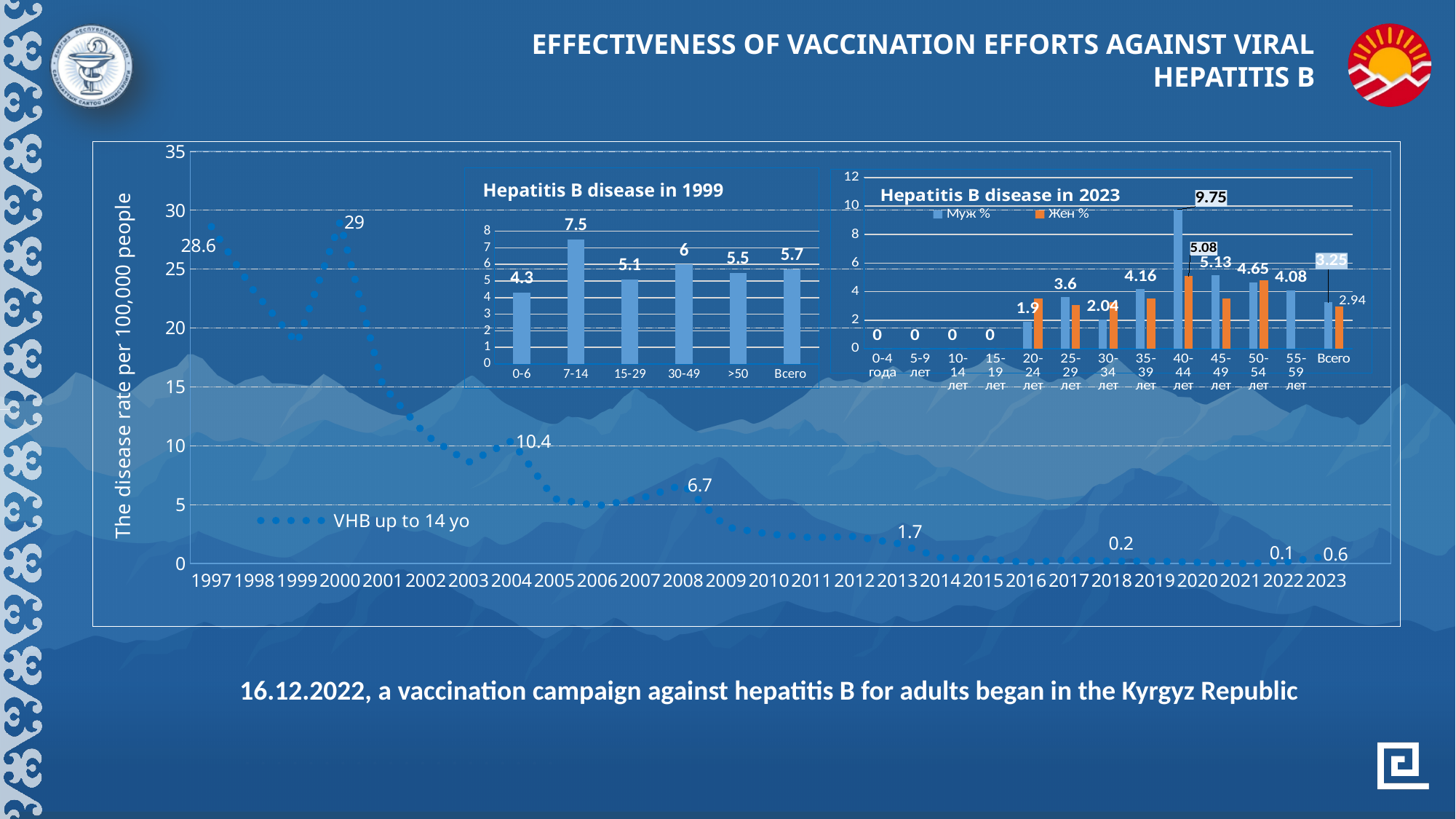
How many series does the legend of the 'Hepatitis B disease in 2023' chart list? 2 In the 'Hepatitis B disease in 2023' chart, which is larger for Муж %: 25-29 лет or 35-39 лет? 35-39 лет On the large line chart, what is the disease rate per 100,000 people in 2000? 29 On the large line chart, does the disease rate rise or fall from 2004 to 2022? fall In the 'Hepatitis B disease in 2023' chart, what is the Муж % value for the 40-44 лет age group? 9.75 How many categories are shown in the 'Hepatitis B disease in 1999' chart? 6 On the large line chart, what is the disease rate per 100,000 people in 2023? 0.6 In the 'Hepatitis B disease in 1999' chart, what is the value for the 30-49 age group? 6 In the 'Hepatitis B disease in 1999' chart, which age group has the lowest value? 0-6 In the 'Hepatitis B disease in 1999' chart, which age group has the highest value? 7-14 On the large line chart, what is the difference between the values for 2000 and 1997? 0.4 What kind of chart is the large chart spanning 1997 to 2023? line chart